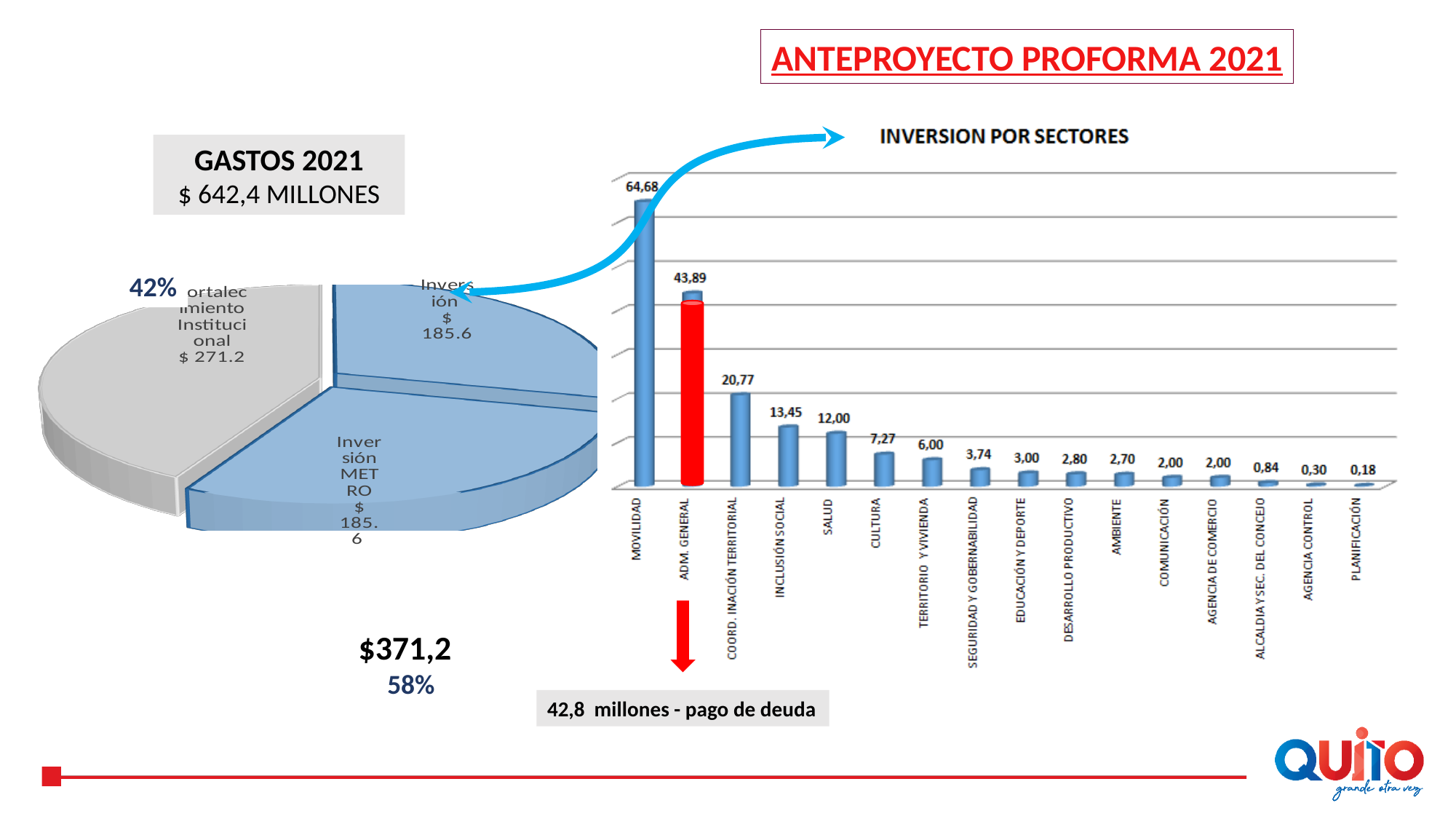
In the INVERSION POR SECTORES chart, what is the value for PLANIFICACIÓN? 0,18 In the INVERSION POR SECTORES chart, which sector has the highest value? MOVILIDAD In the INVERSION POR SECTORES chart, which sector has the lowest value? PLANIFICACIÓN In the INVERSION POR SECTORES chart, which bar is coloured red? ADM. GENERAL How many sectors are shown in the INVERSION POR SECTORES chart? 16 In the INVERSION POR SECTORES chart, which is larger, INCLUSIÓN SOCIAL or CULTURA? INCLUSIÓN SOCIAL In the INVERSION POR SECTORES chart, do the values rise or fall from left to right? Fall What kind of chart is INVERSION POR SECTORES? Bar chart In the INVERSION POR SECTORES chart, what is the difference between MOVILIDAD and ADM. GENERAL? 20,79 In the GASTOS 2021 pie chart, what is the value of the Inversión METRO slice? $ 185.6 In the INVERSION POR SECTORES chart, what is the value for SALUD? 12,00 In the INVERSION POR SECTORES chart, what is the value for MOVILIDAD? 64,68